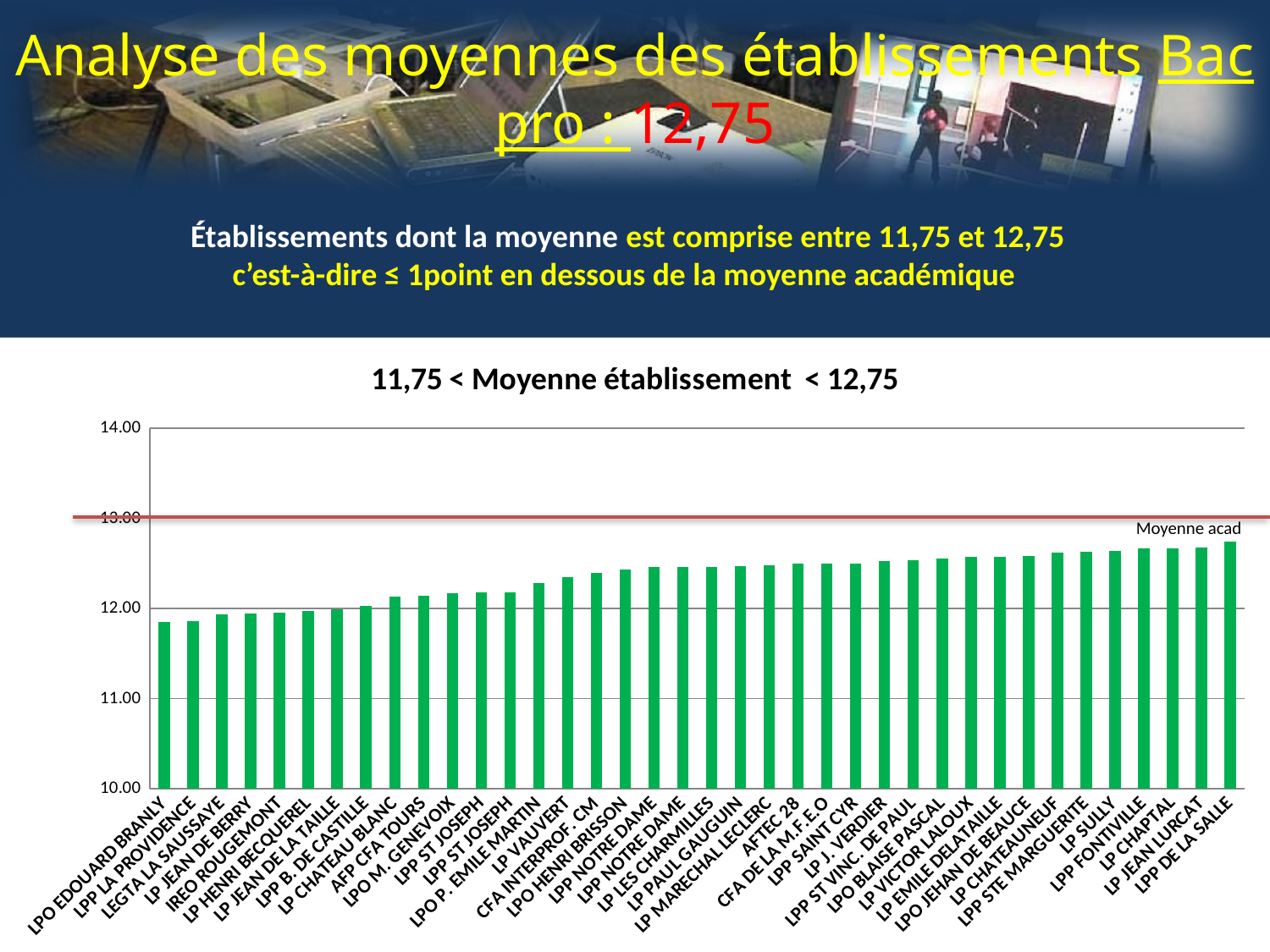
How many establishments (bars) are plotted on the chart? 38 Do the bar values rise or fall from left to right along the x axis? rise Which establishment has the highest bar on the chart? LPP DE LA SALLE What is the title of the chart? 11,75 < Moyenne établissement < 12,75 What kind of chart is shown on the slide? bar chart Is the value for LP SULLY greater or less than 13.00? less Which is larger, the value for LP VAUVERT or the value for LP JEAN DE BERRY? LP VAUVERT Is the value for LPO EDOUARD BRANLY greater or less than 12.00? less What label is attached to the red horizontal line on the chart? Moyenne acad Is the value for LPP DE LA SALLE greater or less than 12.00? greater Which is larger, the value for LPP DE LA SALLE or the value for LPO EDOUARD BRANLY? LPP DE LA SALLE